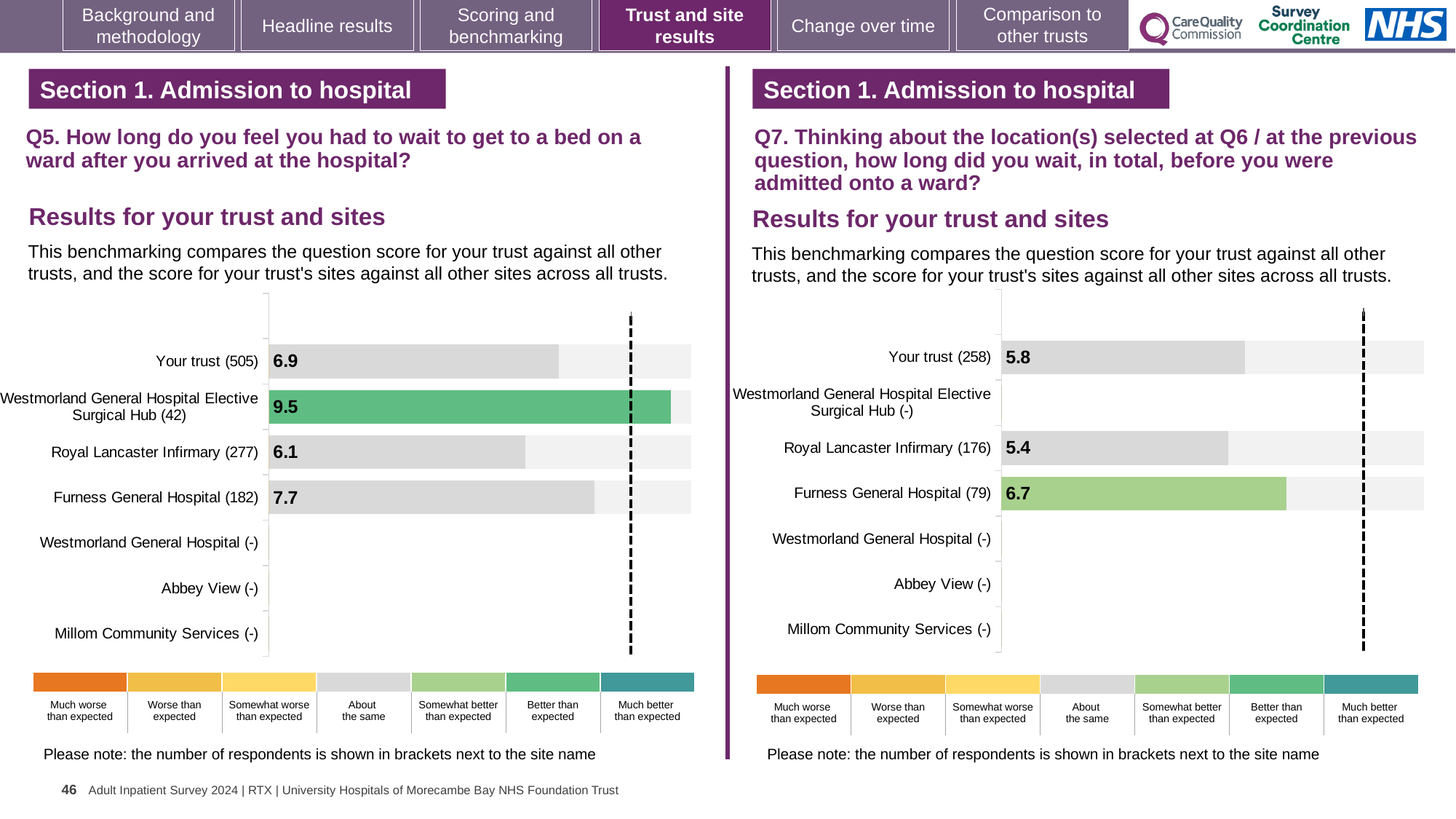
In the Q5 chart on the left, which site has the lowest score? Royal Lancaster Infirmary (277) In the Q5 chart on the left, what is the score for Westmorland General Hospital Elective Surgical Hub (42)? 9.5 In the Q7 chart on the right, what is the difference between the scores for Furness General Hospital (79) and Royal Lancaster Infirmary (176)? 1.3 In the Q7 chart on the right, which site has the highest score? Furness General Hospital (79) In the Q7 chart on the right, is the score for Royal Lancaster Infirmary (176) larger or smaller than the score for Your trust (258)? smaller What kind of chart is used on the left for Q5? Bar chart In the Q7 chart on the right, what is the score for Your trust (258)? 5.8 In the Q7 chart on the right, what is the score for Furness General Hospital (79)? 6.7 In the Q5 chart on the left, what is the score for Your trust (505)? 6.9 In the Q5 chart on the left, what is the difference between the scores for Furness General Hospital (182) and Royal Lancaster Infirmary (277)? 1.6 In the Q5 chart on the left, how many sites have a score shown as a bar? 4 In the Q5 chart on the left, which site has the highest score? Westmorland General Hospital Elective Surgical Hub (42)